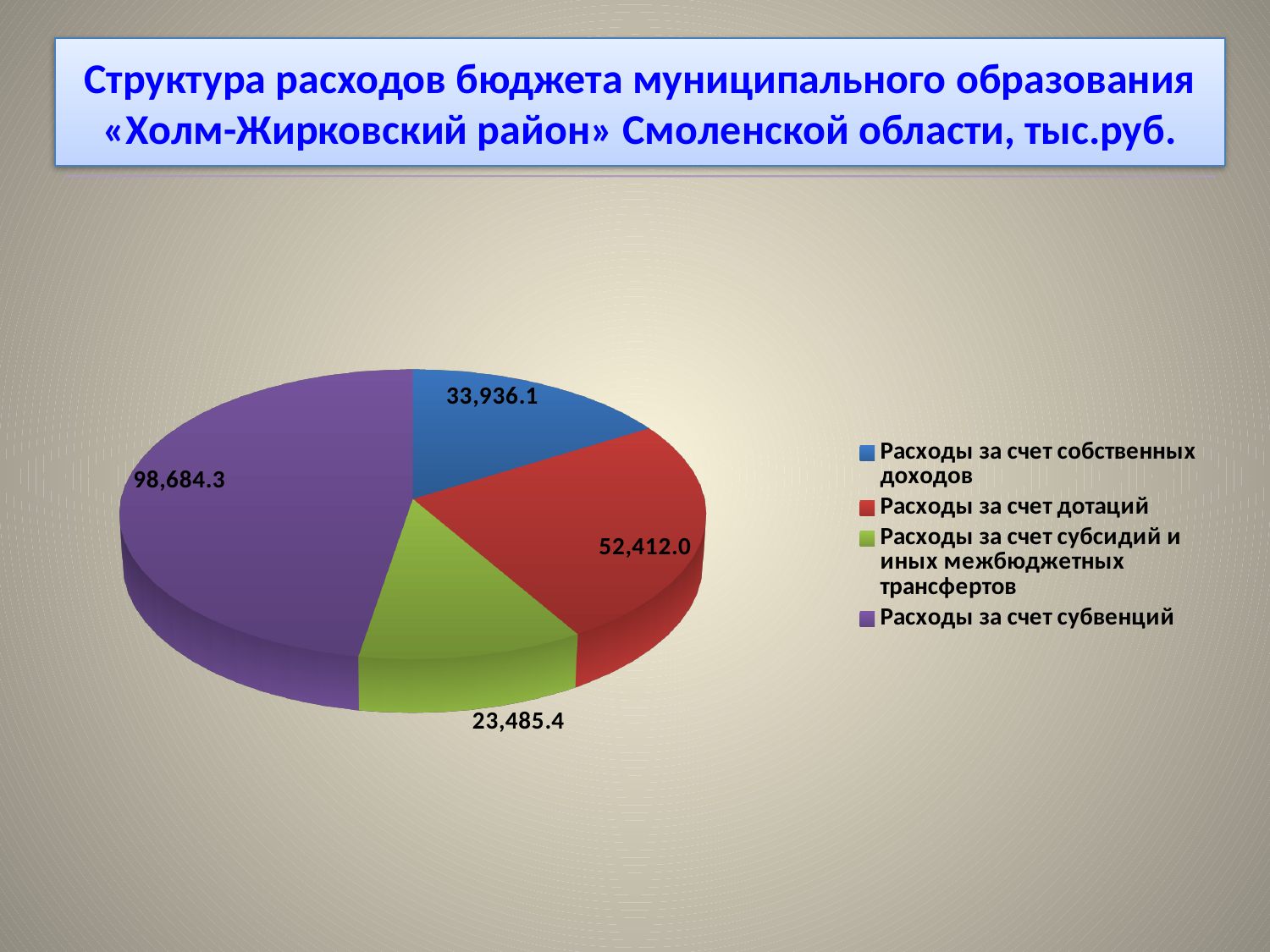
What is the difference between «Расходы за счет субвенций» and «Расходы за счет дотаций»? 46,272.3 What is the value for «Расходы за счет собственных доходов»? 33,936.1 Which category has the largest slice of the pie? Расходы за счет субвенций What colour is the slice for «Расходы за счет дотаций»? Red How many slices does the pie chart have? 4 Which is larger: «Расходы за счет собственных доходов» or «Расходы за счет субсидий и иных межбюджетных трансфертов»? Расходы за счет собственных доходов What is the difference between «Расходы за счет дотаций» and «Расходы за счет собственных доходов»? 18,475.9 What is the value for «Расходы за счет субсидий и иных межбюджетных трансфертов»? 23,485.4 Which category has the smallest slice of the pie? Расходы за счет субсидий и иных межбюджетных трансфертов What is the value for «Расходы за счет дотаций»? 52,412.0 What is the value for «Расходы за счет субвенций»? 98,684.3 What kind of chart is shown on the slide? Pie chart